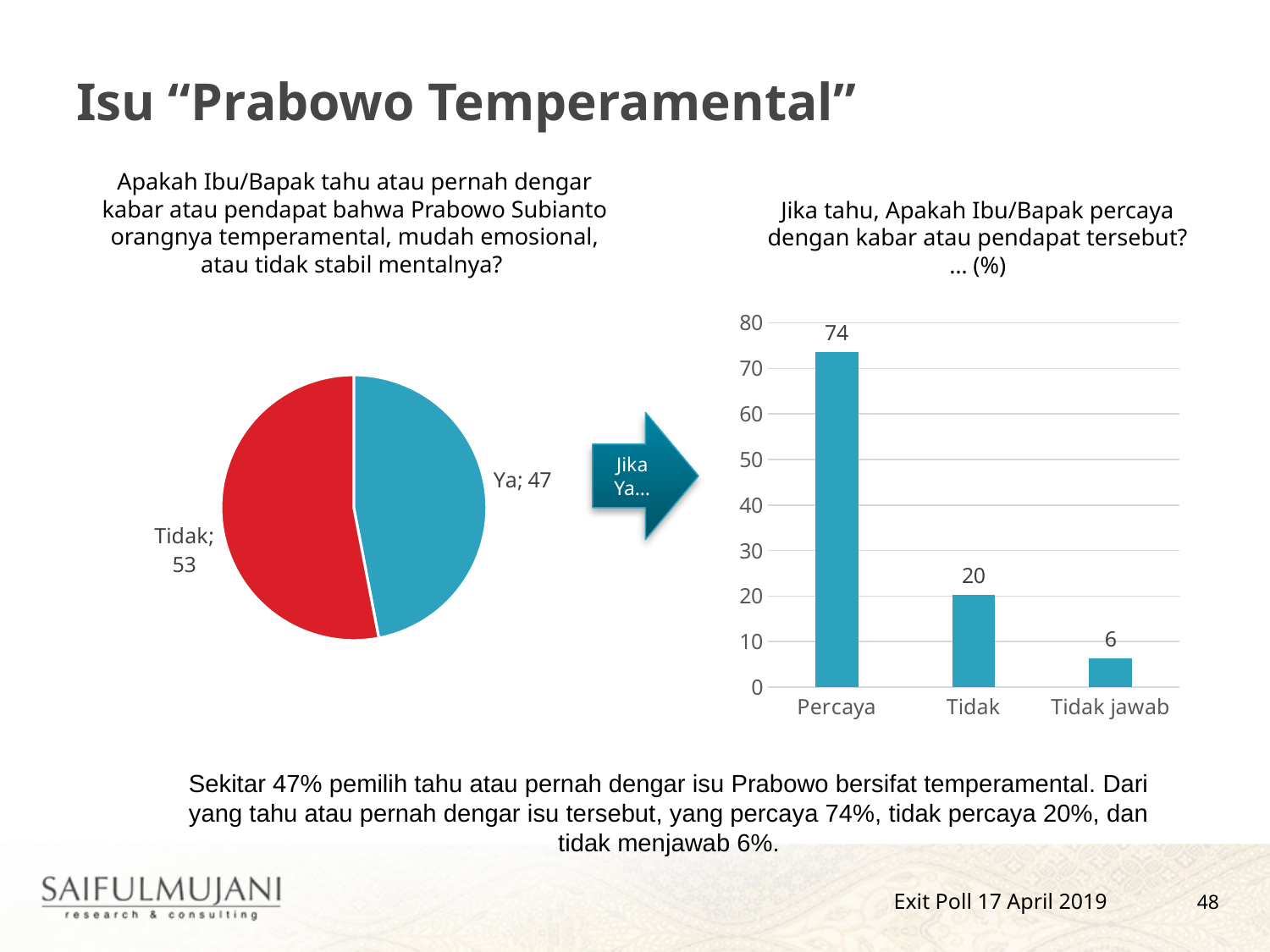
In the pie chart on the left, which slice is larger, "Ya" or "Tidak"? Tidak In the pie chart on the left, what is the value for "Tidak"? 53 In the bar chart on the right, what is the difference between the "Percaya" and "Tidak" values? 54 In the pie chart on the left, what is the value for "Ya"? 47 How many slices does the pie chart on the left have? 2 In the pie chart on the left, what is the difference between the "Tidak" and "Ya" values? 6 In the bar chart on the right, which category has the lowest value? Tidak jawab What type of chart is shown on the right side of the slide? Bar chart In the bar chart on the right, what is the value for "Tidak jawab"? 6 How many categories are shown in the bar chart on the right? 3 In the bar chart on the right, which category has the highest value? Percaya In the bar chart on the right, what is the value for "Percaya"? 74